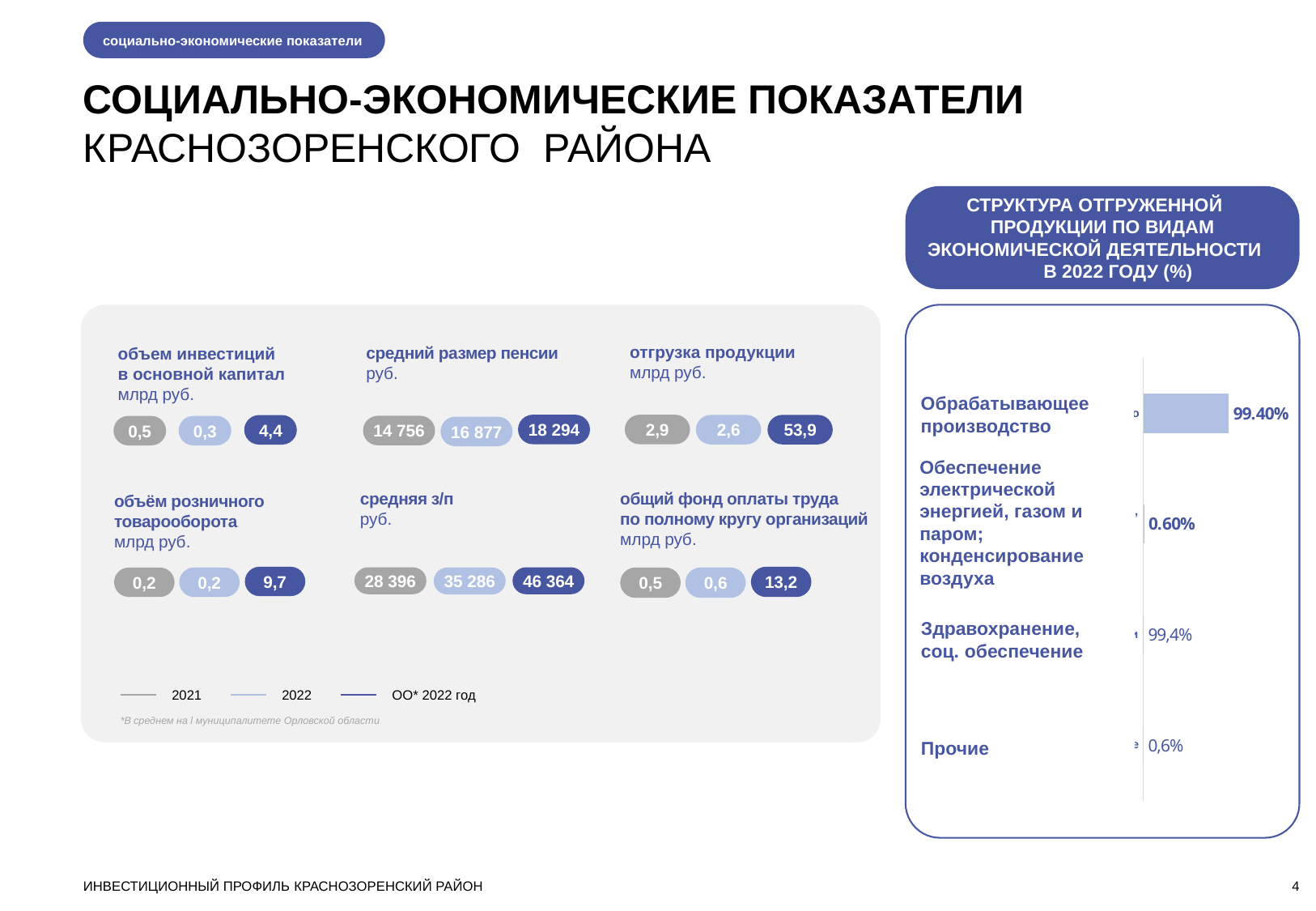
In the chart 'Структура отгруженной продукции по видам экономической деятельности в 2022 году (%)', what value is shown for 'Обеспечение электрической энергией, газом и паром; конденсирование воздуха'? 0.60% In the chart 'Структура отгруженной продукции по видам экономической деятельности в 2022 году (%)', what value is shown next to 'Прочие'? 0,6% In the chart 'Структура отгруженной продукции по видам экономической деятельности в 2022 году (%)', which is larger: the value for 'Обрабатывающее производство' or the value for 'Обеспечение электрической энергией, газом и паром; конденсирование воздуха'? Обрабатывающее производство What is the title of the chart on the right side of the slide? Структура отгруженной продукции по видам экономической деятельности в 2022 году (%) In the chart 'Структура отгруженной продукции по видам экономической деятельности в 2022 году (%)', what value is shown for 'Обрабатывающее производство'? 99.40% In the chart 'Структура отгруженной продукции по видам экономической деятельности в 2022 году (%)', what value is shown next to 'Здравоохранение, соц. обеспечение'? 99,4% What kind of chart is shown on the right side of the slide under the title 'Структура отгруженной продукции по видам экономической деятельности в 2022 году (%)'? bar chart In the chart 'Структура отгруженной продукции по видам экономической деятельности в 2022 году (%)', what is the difference between the value for 'Обрабатывающее производство' (99.40%) and the value for 'Обеспечение электрической энергией, газом и паром; конденсирование воздуха' (0.60%)? 98.80% How many categories are listed in the chart 'Структура отгруженной продукции по видам экономической деятельности в 2022 году (%)'? 4 In the chart 'Структура отгруженной продукции по видам экономической деятельности в 2022 году (%)', which category is listed first (at the top)? Обрабатывающее производство